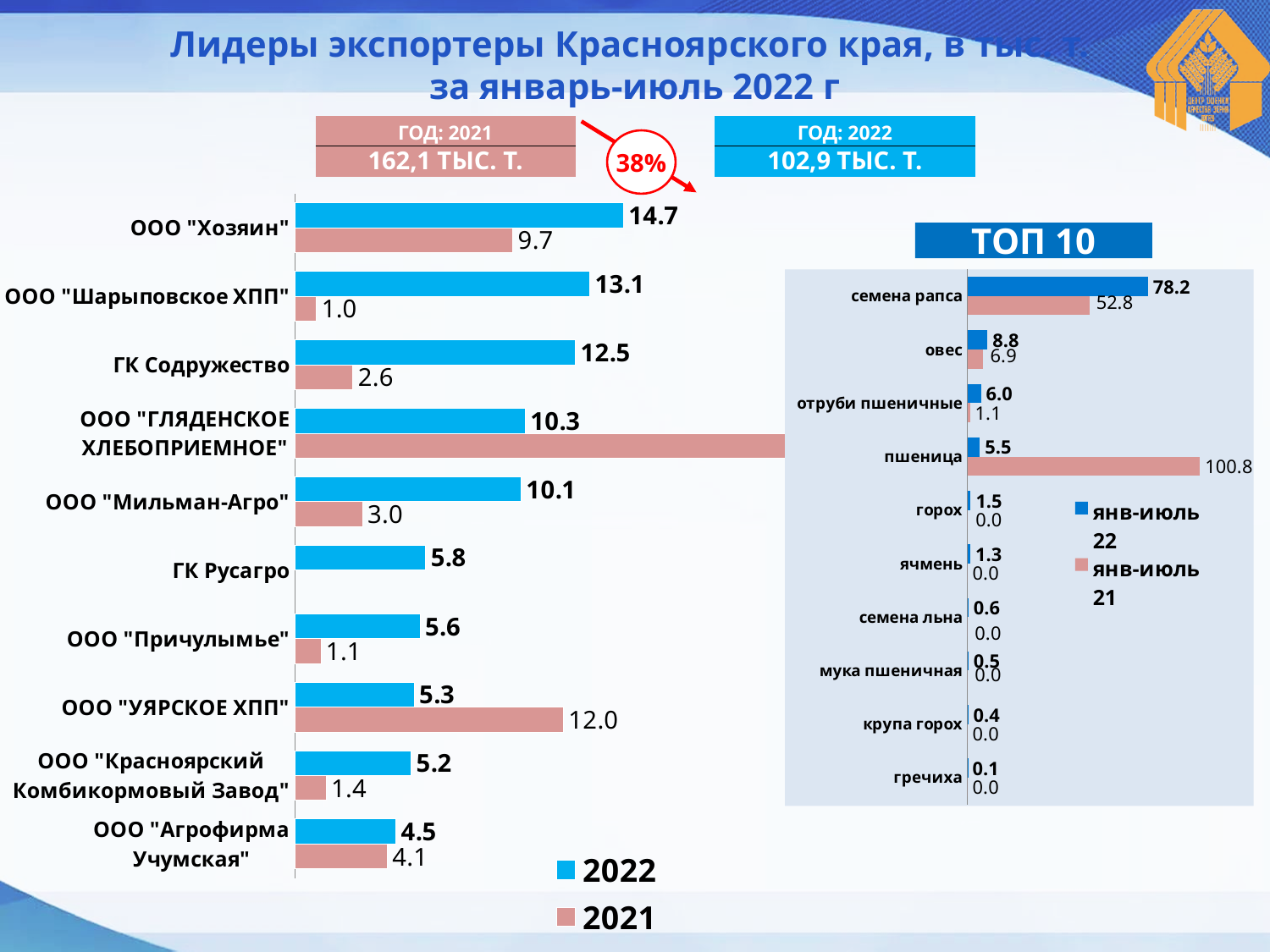
On the ТОП 10 chart, what is the янв-июль 22 value for семена рапса? 78.2 On the ТОП 10 chart, which is larger for овес: the янв-июль 22 value or the янв-июль 21 value? янв-июль 22 On the left chart of leading exporters, how many exporters are shown? 10 On the left chart of leading exporters, what is the difference between the 2022 and 2021 values for ГК Содружество? 9.9 On the left chart of leading exporters, what is the 2022 value for ООО "Хозяин"? 14.7 On the left chart of leading exporters, which exporter has the lowest 2022 value? ООО "Агрофирма Учумская" On the left chart of leading exporters, what is the 2021 value for ООО "УЯРСКОЕ ХПП"? 12.0 On the ТОП 10 chart, what is the difference between the янв-июль 22 and янв-июль 21 values for семена рапса? 25.4 On the ТОП 10 chart, what is the янв-июль 21 value for пшеница? 100.8 On the left chart of leading exporters, how many series does the legend list? 2 On the left chart of leading exporters, which exporter has the highest 2022 value? ООО "Хозяин" What type of chart is the ТОП 10 chart? Bar chart